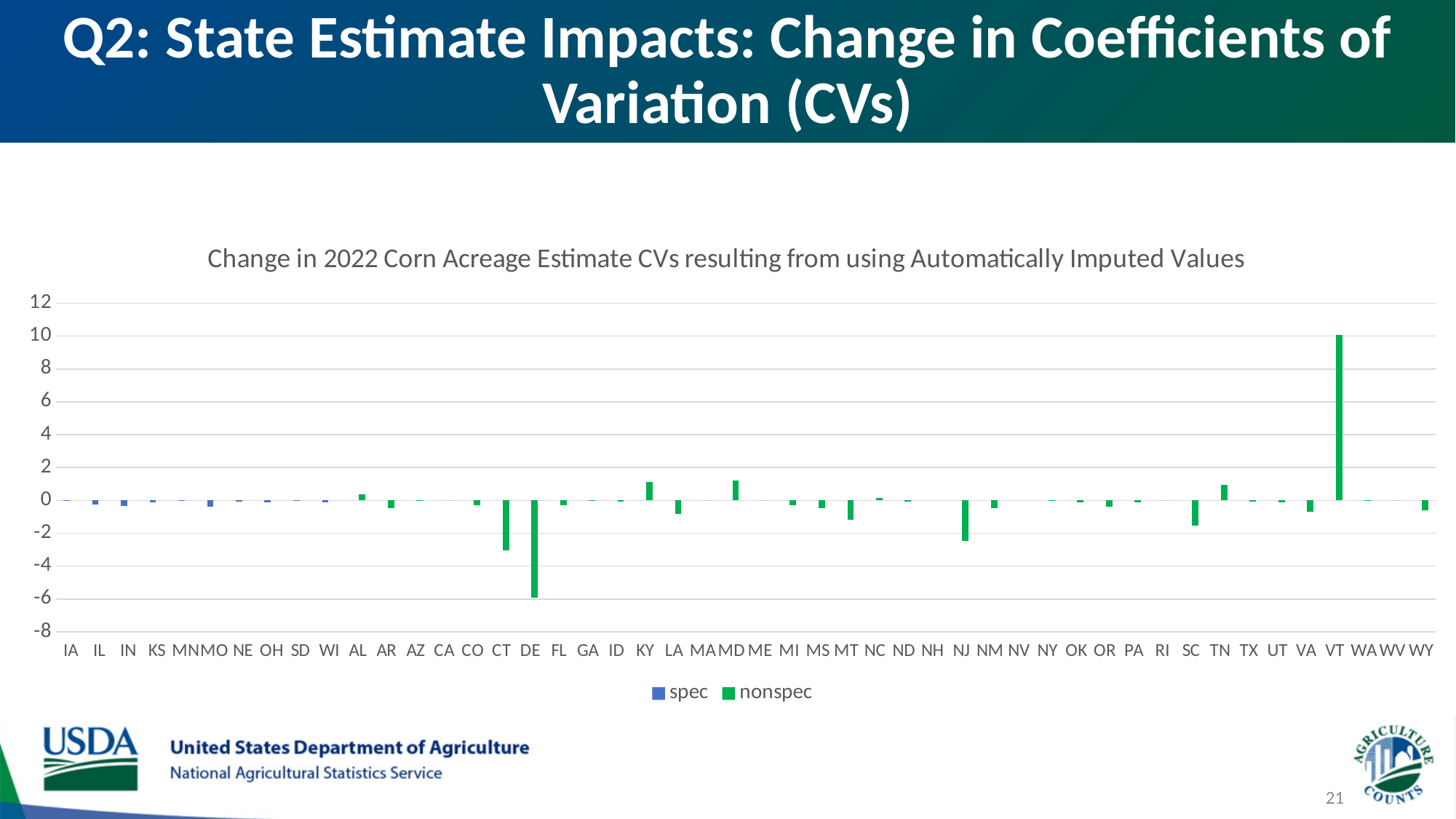
Is the nonspec value for VT greater or less than 8? greater What are the two series named in the legend? spec and nonspec Which state has the lowest nonspec value? DE Which state has the larger nonspec value, VT or KY? VT What kind of chart is shown on the slide? bar chart How many series does the legend list? 2 Which state has the highest nonspec value? VT What is the title of the chart? Change in 2022 Corn Acreage Estimate CVs resulting from using Automatically Imputed Values Is the nonspec value for NJ greater or less than -2? less How many states are shown on the x axis? 48 Is the nonspec value for CT greater or less than -2? less